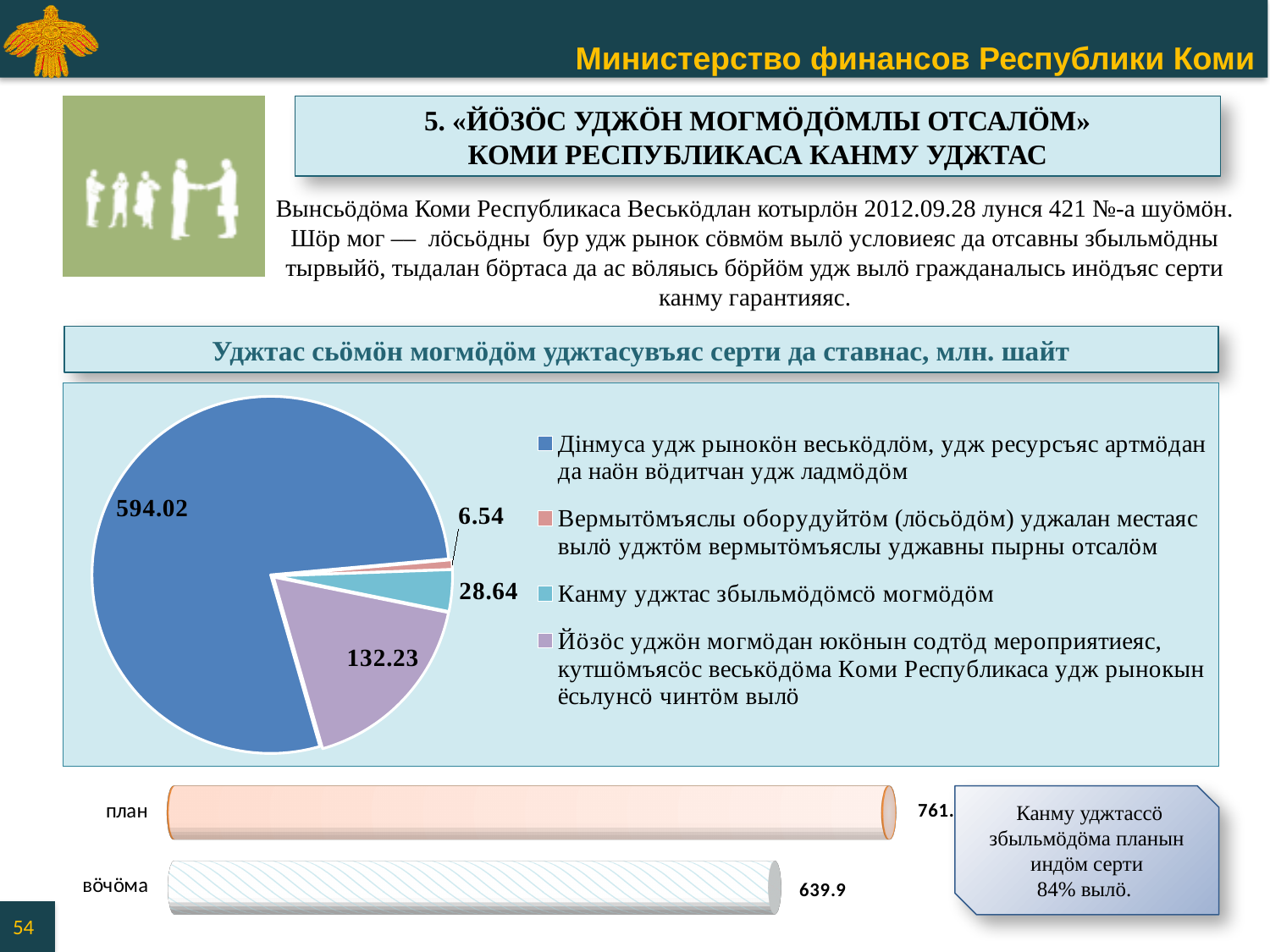
In the pie chart, what is the value of the slice for Канму уджтас збыльмöдöмсö могмöдöм? 28.64 In the pie chart, what is the value of the largest slice (Дінмуса удж рынокöн веськöдлöм...)? 594.02 In the pie chart, how many slices are there? 4 In the pie chart, what is the value of the smallest slice? 6.54 In the pie chart, what is the value of the purple slice (Йöзöс уджöн могмöдан юкöнын содтöд мероприятиеяс...)? 132.23 What type of chart is shown at the bottom of the slide with the categories план and вöчöма? bar chart In the pie chart, what is the difference between the largest slice (594.02) and the purple slice (132.23)? 461.79 How many entries does the legend of the pie chart list? 4 In the bar chart at the bottom of the slide, what is the value for вöчöма? 639.9 In the bar chart at the bottom of the slide, which bar is longer: план or вöчöма? план In the pie chart, which legend entry corresponds to the smallest slice? Вермытöмъяслы оборудуйтöм (лöсьöдöм) уджалан местаяс вылö уджтöм вермытöмъяслы уджавны пырны отсалöм In the pie chart, which is larger: the slice for Канму уджтас збыльмöдöмсö могмöдöм or the slice for Йöзöс уджöн могмöдан юкöнын содтöд мероприятиеяс? Йöзöс уджöн могмöдан юкöнын содтöд мероприятиеяс